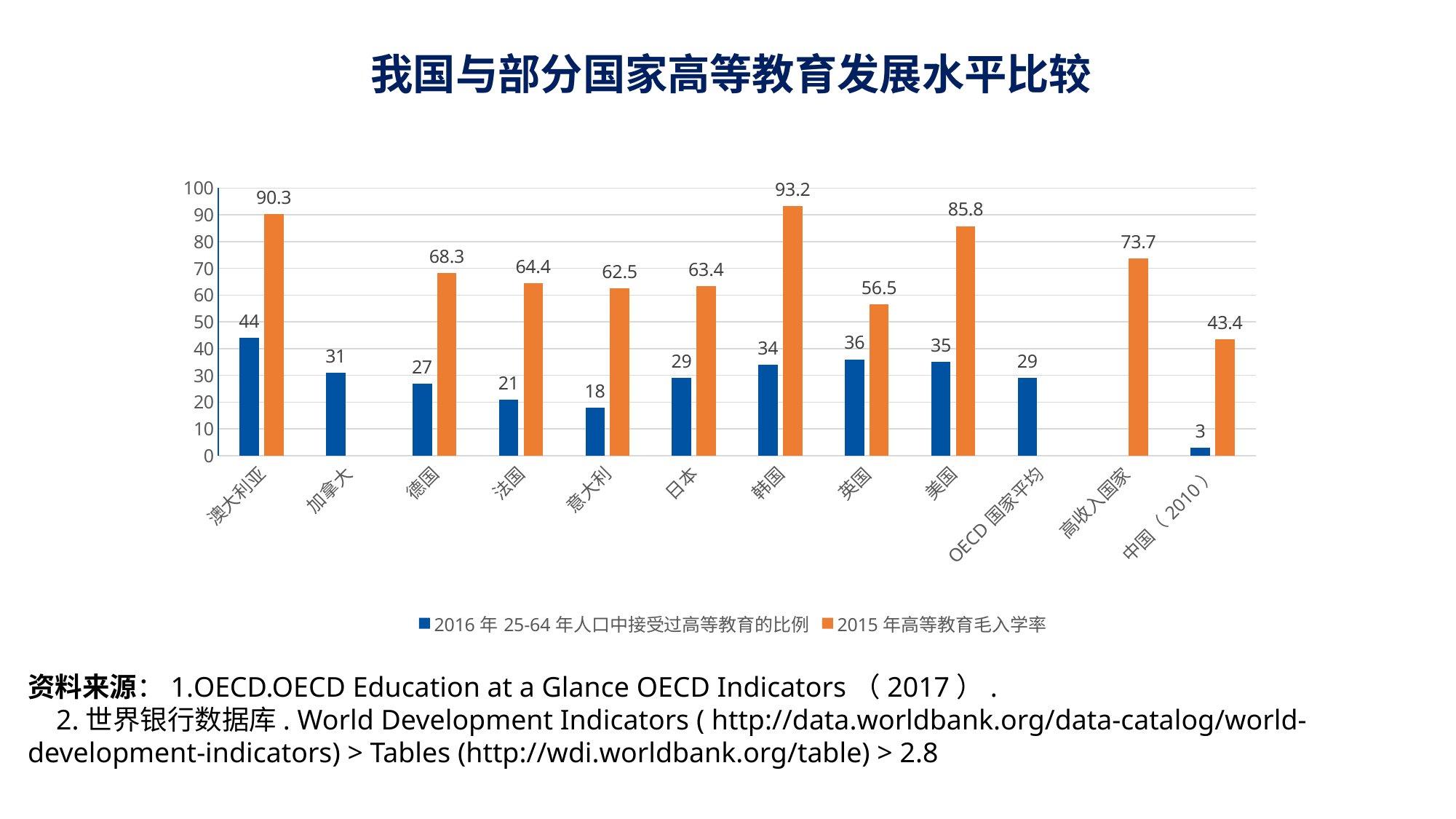
How many series does the legend list? 2 Which category has the lowest value for 2016 年 25-64 年人口中接受过高等教育的比例? 中国（2010） What is the value of 2016 年 25-64 年人口中接受过高等教育的比例 for 中国（2010）? 3 What is the value of 2015 年高等教育毛入学率 for 韩国? 93.2 Is the 2015 年高等教育毛入学率 value for 美国 greater or less than 80? greater What is the difference between the 2015 年高等教育毛入学率 values for 澳大利亚 and 中国（2010）? 46.9 What type of chart is shown on the slide? bar chart Which category has the highest value for 2015 年高等教育毛入学率? 韩国 What is the value of 2015 年高等教育毛入学率 for 高收入国家? 73.7 How many categories are shown on the x axis? 12 Which is larger, the 2016 年 25-64 年人口中接受过高等教育的比例 value for 英国 or for 德国? 英国 What is the title of the chart? 我国与部分国家高等教育发展水平比较